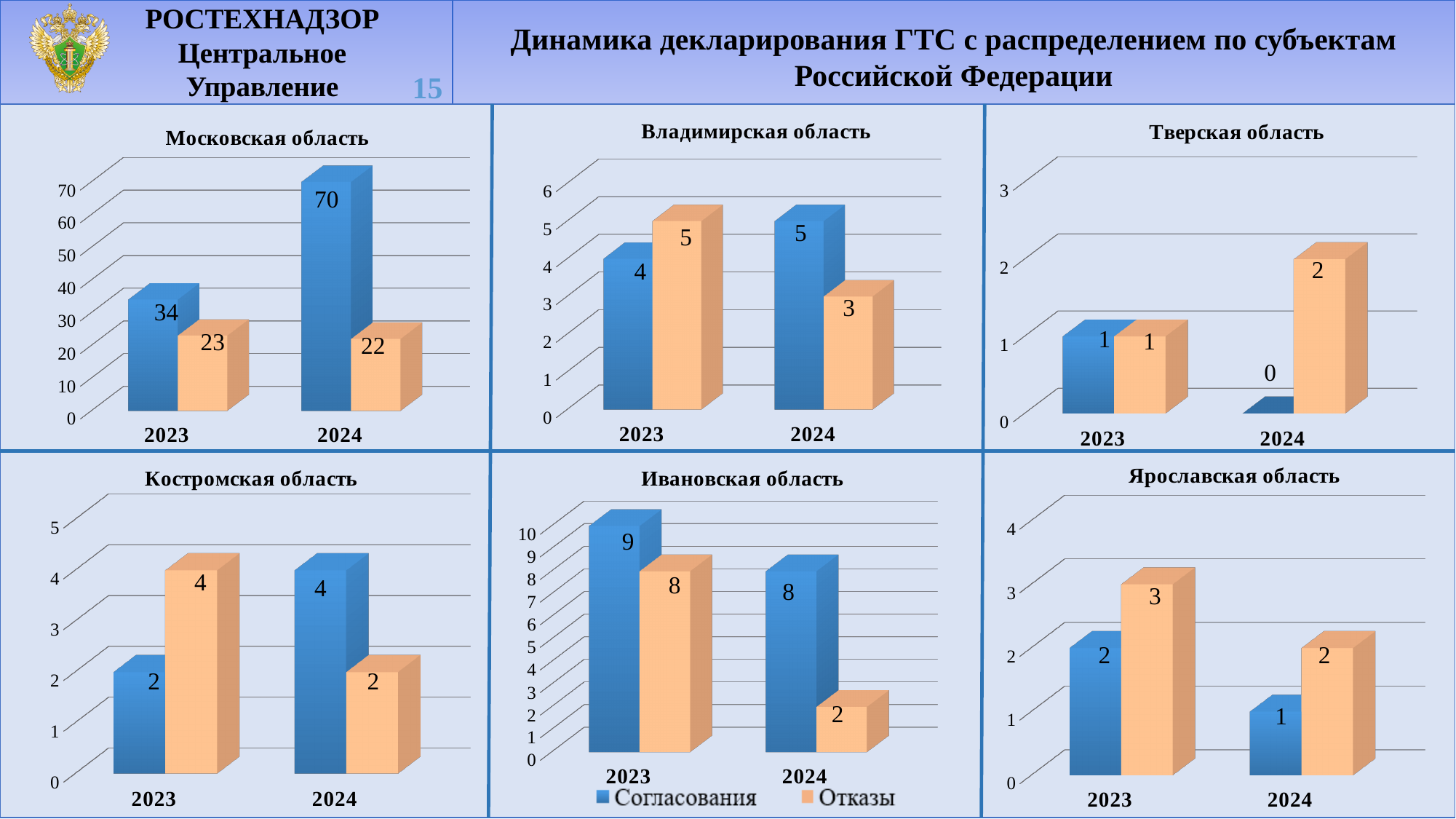
In the Ивановская область chart, what is the value of Согласования for 2023? 9 In the Ярославская область chart, what is the value of Отказы for 2024? 2 In the Владимирская область chart, which is larger in 2024: Согласования or Отказы? Согласования In the Костромская область chart, what is the value of Отказы for 2023? 4 In the Московская область chart, what is the difference between Согласования in 2024 and 2023? 36 How many series does the legend under the Ивановская область chart list? 2 In the Московская область chart, what is the value of Согласования for 2024? 70 In the Тверская область chart, what is the value of Согласования for 2024? 0 In the Ивановская область chart, do the Отказы values rise or fall from 2023 to 2024? fall In the Владимирская область chart, what is the value of Отказы for 2023? 5 In the Ярославская область chart, which year has the lowest Согласования value? 2024 What type of chart is used for Московская область? bar chart